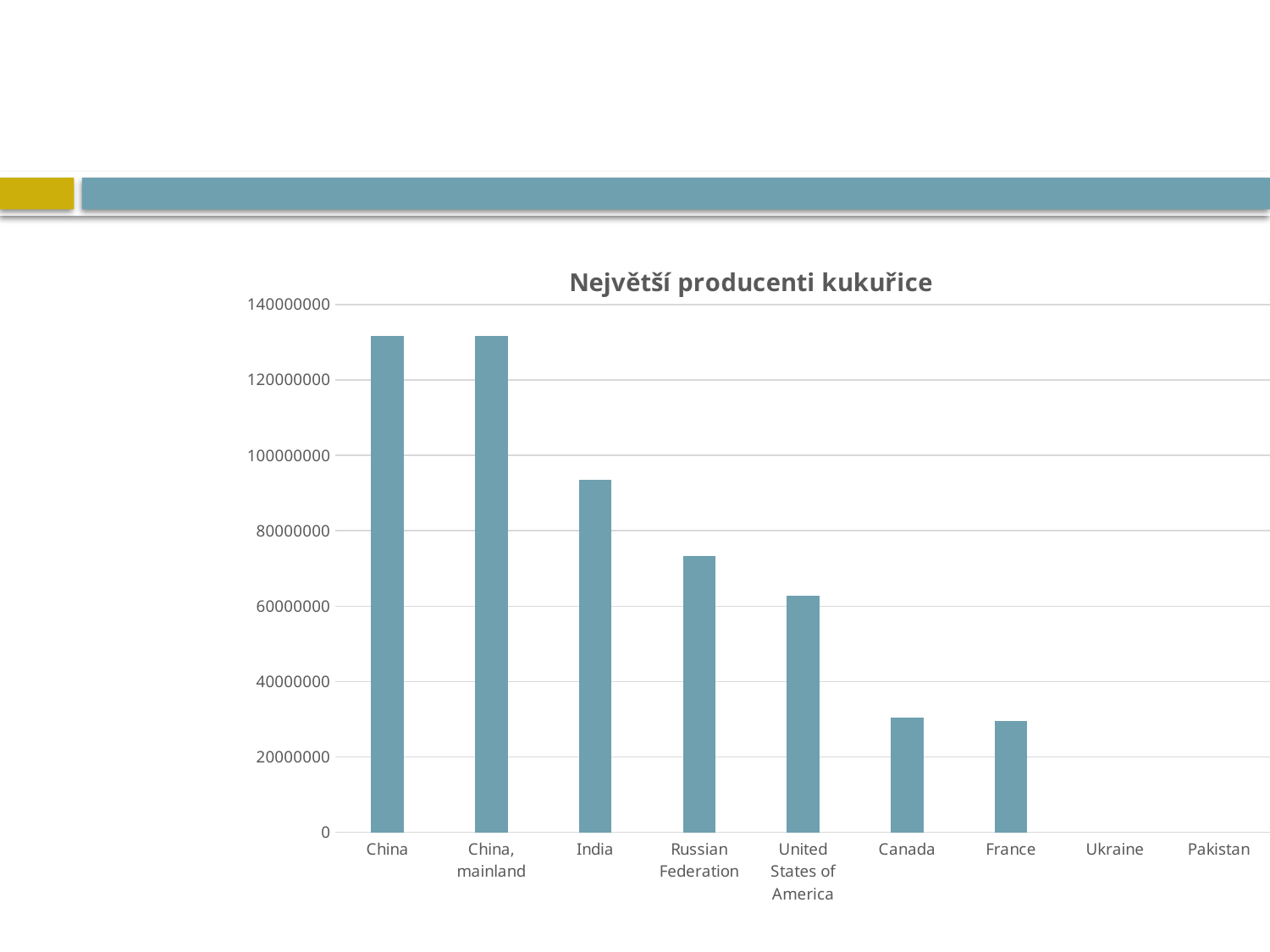
What kind of chart is shown on the slide? bar chart How many categories are listed on the x axis of the chart? 9 Is the value for India greater or less than 80000000? greater What is the title of the chart? Největší producenti kukuřice Is the value for United States of America greater or less than 60000000? greater Which has the larger value, India or Russian Federation? India Which has the larger value, United States of America or Canada? United States of America Is the value for Canada greater or less than 40000000? less Do the bar values generally rise or fall from left to right along the x axis? fall